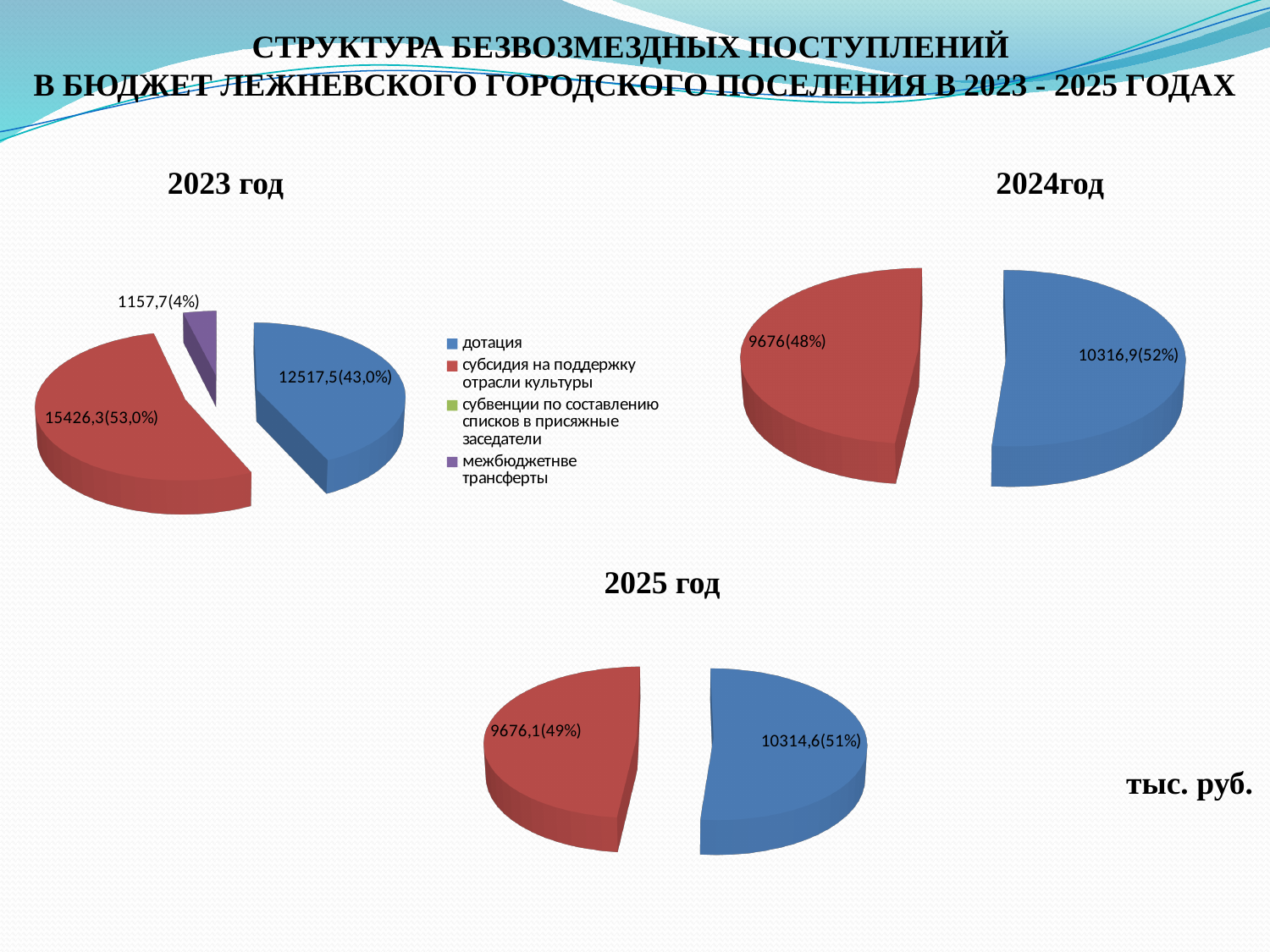
In the 2023 год chart, which category has the smallest slice? межбюджетнве трансферты In the 2023 год chart, what share of the pie does субсидия на поддержку отрасли культуры take? 53,0% In the 2025 год chart, which is larger: дотация or субсидия на поддержку отрасли культуры? дотация In the 2024год chart, what share of the pie does субсидия на поддержку отрасли культуры take? 48% In the 2023 год chart, what is the difference between субсидия на поддержку отрасли культуры and дотация? 2908,8 How many slices are shown in the 2023 год chart? 3 In the 2025 год chart, what is the value shown for субсидия на поддержку отрасли культуры? 9676,1 In the 2024год chart, what is the value shown for дотация? 10316,9 In the 2024год chart, which category has the largest slice? дотация In the 2023 год chart, what is the value shown for дотация? 12517,5 How many entries does the legend list? 4 In the 2023 год chart, what is the value shown for межбюджетнве трансферты? 1157,7